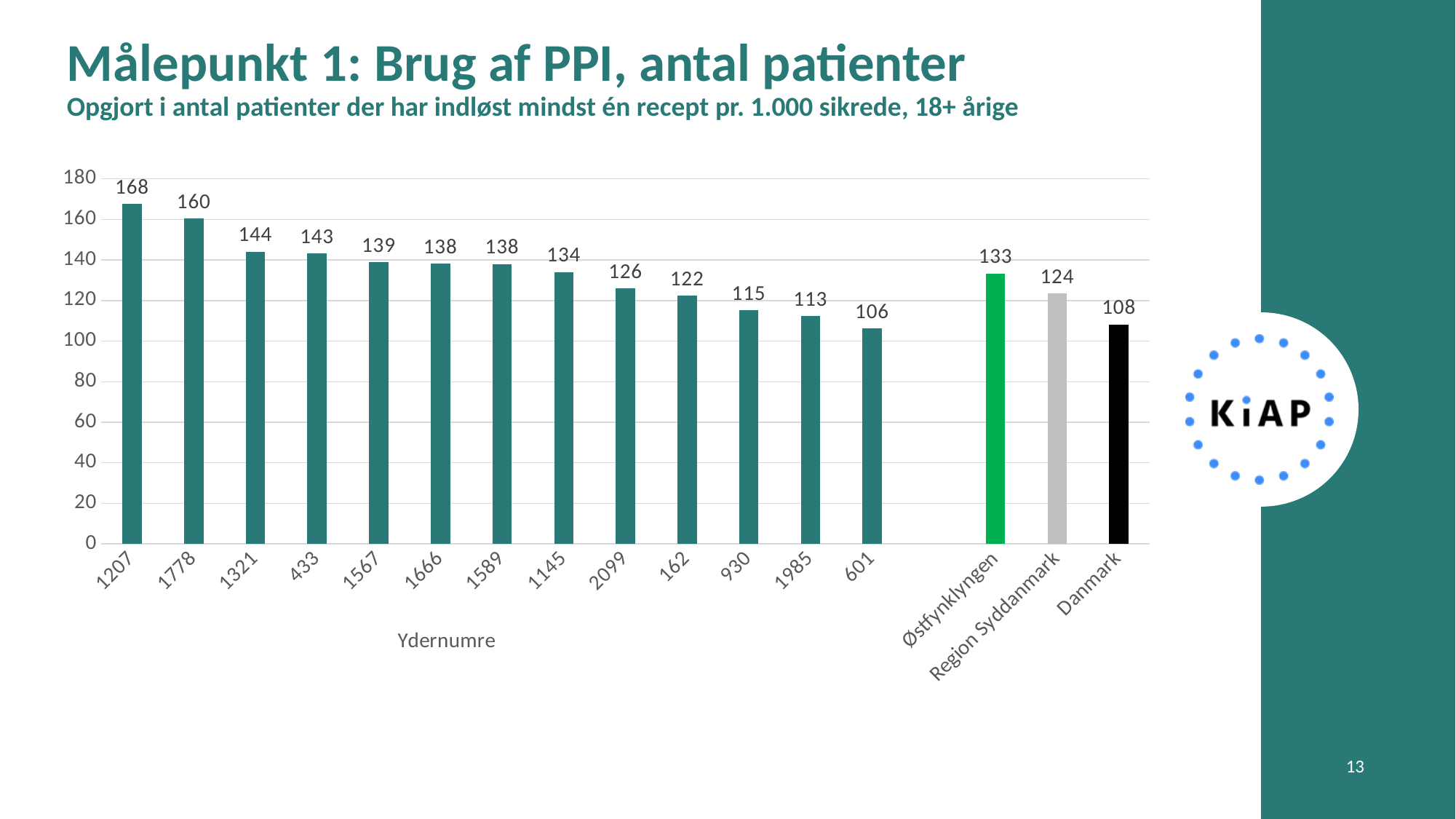
What is the value for Danmark? 108 What is the difference between the values for Østfynklyngen and Danmark? 25 What is the value for ydernummer 1207? 168 Is the value for 930 greater or less than 120? less Which category has the lowest value? 601 What type of chart is shown on the slide? bar chart How many bars are shown in the chart? 16 What is the value for Østfynklyngen? 133 What is the value for Region Syddanmark? 124 What is the difference between the values for 1207 and 601? 62 Which is larger, the value for 1778 or the value for 1321? 1778 Which category has the highest value? 1207